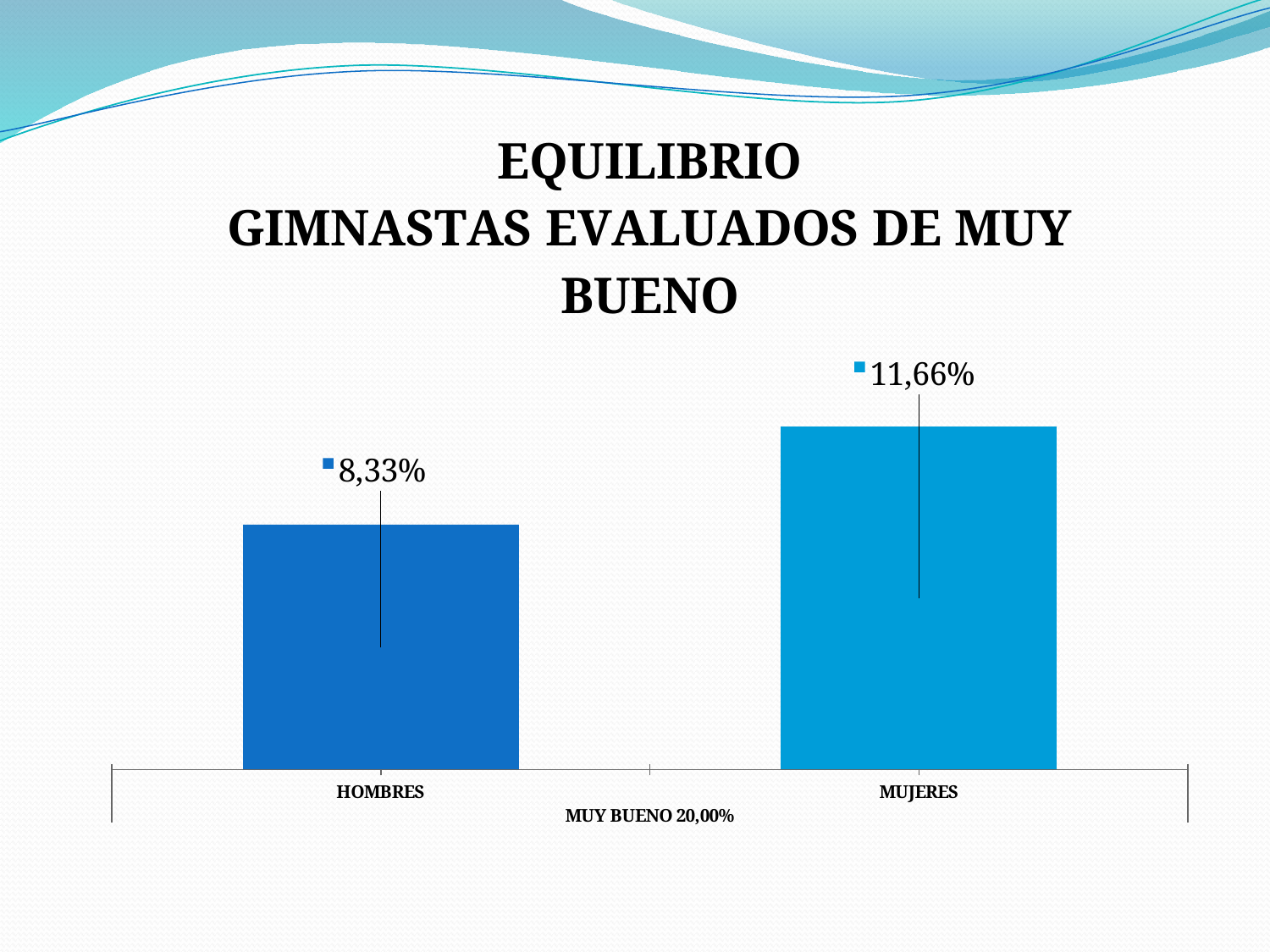
What is the title of the slide? EQUILIBRIO GIMNASTAS EVALUADOS DE MUY BUENO What kind of chart is shown on the slide? Bar chart What label appears below the category names on the x axis? MUY BUENO 20,00% Which category has the lowest value? HOMBRES What is the difference between the values for MUJERES and HOMBRES? 3,33% How many categories are shown on the x axis? 2 Which is larger, the value for HOMBRES or the value for MUJERES? MUJERES What is the value for HOMBRES? 8,33% What is the value for MUJERES? 11,66% Which category has the highest value? MUJERES